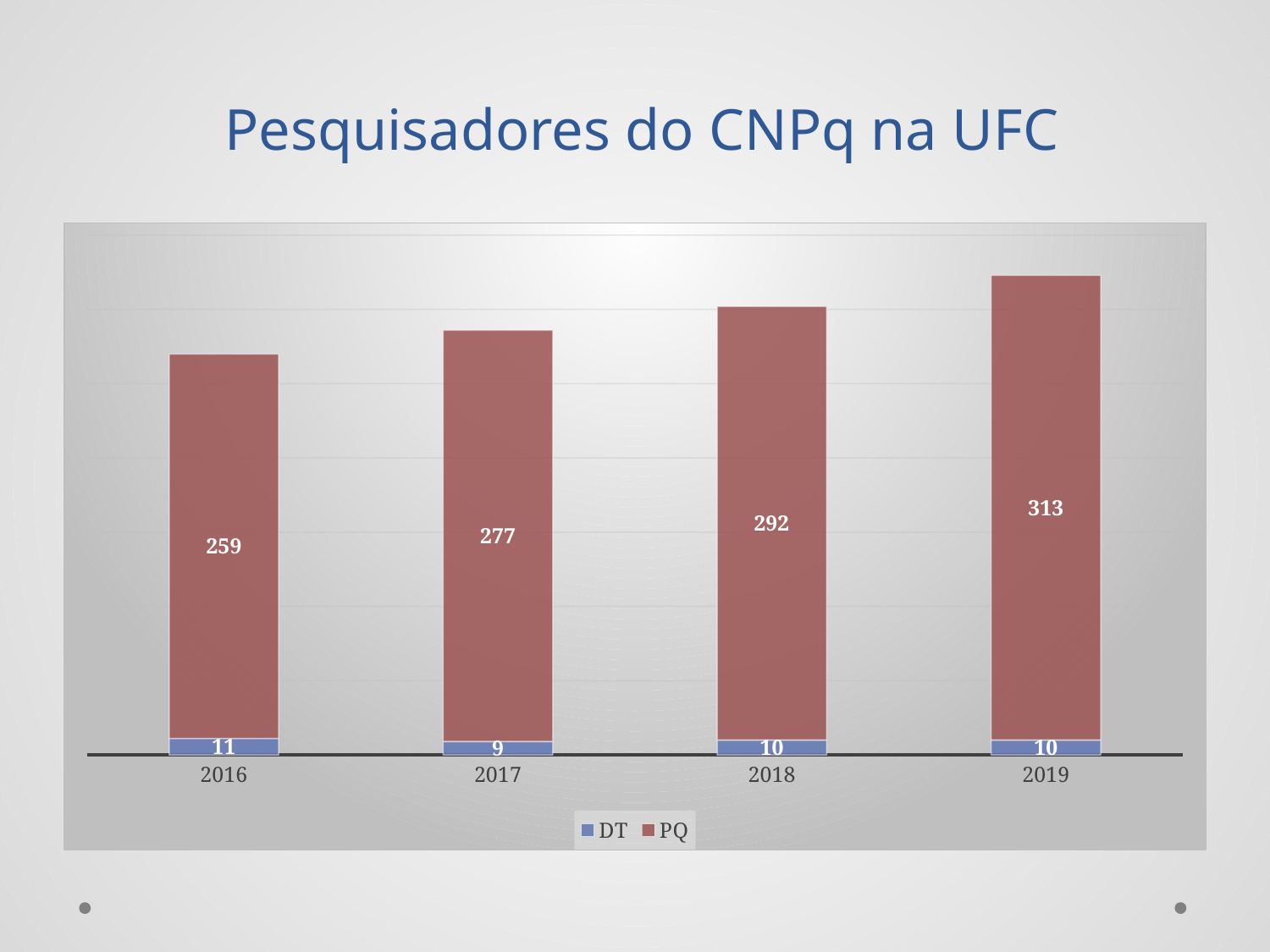
Which year has the highest PQ value? 2019 What is the PQ value for 2019? 313 What is the DT value for 2016? 11 What is the difference between the PQ values for 2019 and 2016? 54 Which year has the lowest DT value? 2017 How many years are shown on the x axis? 4 What kind of chart is shown on the slide? Stacked bar chart What is the total of the stacked bar for 2017? 286 Which is larger, the PQ value for 2017 or the PQ value for 2018? 2018 What is the PQ value for 2018? 292 How many series does the legend list? 2 Do the PQ values rise or fall from 2016 to 2019? Rise